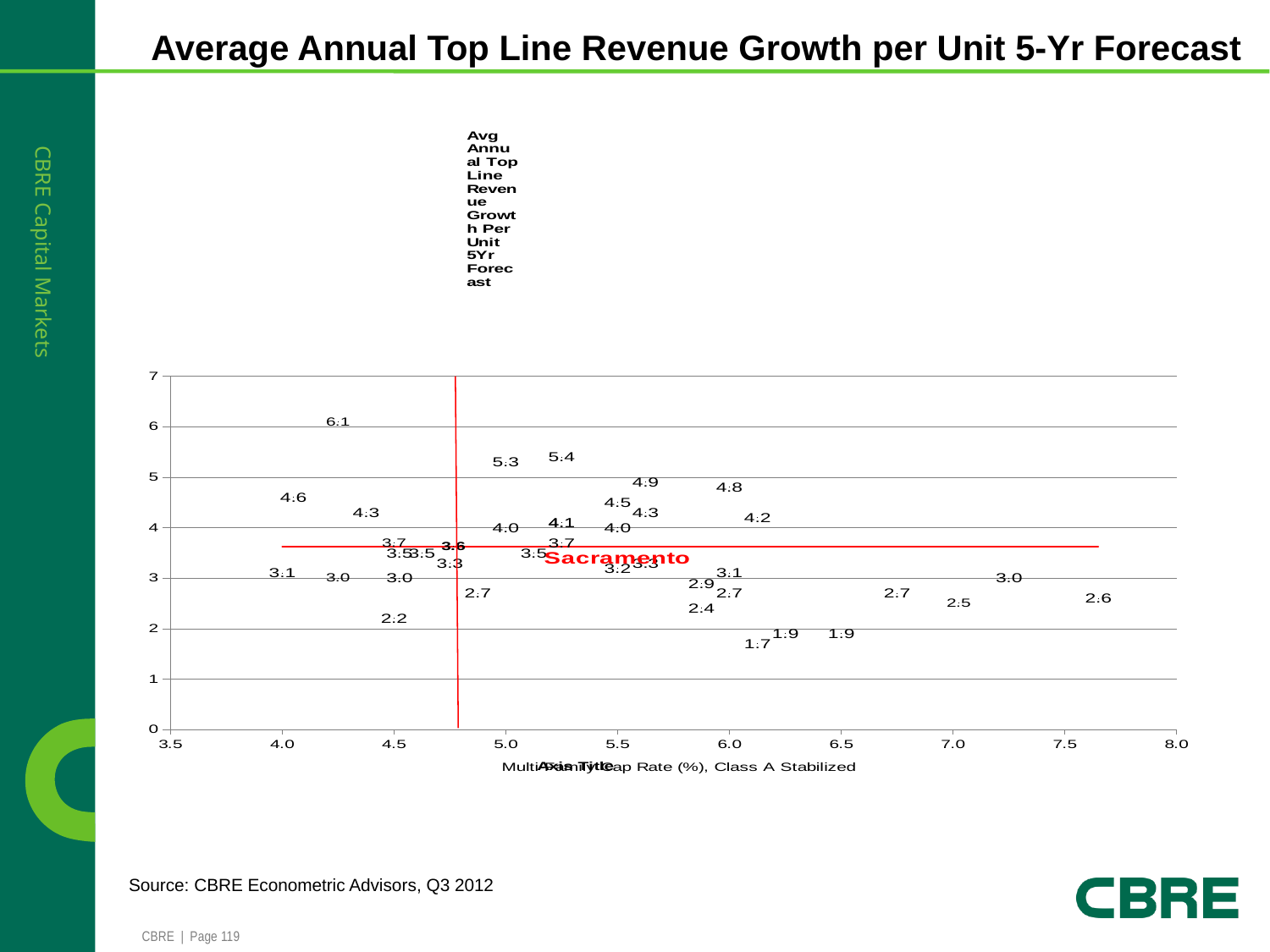
Is the cap rate (x-axis value) for Sacramento greater or less than 4.5? greater What is the highest data label value shown on the chart? 6.1 What is the average annual top line revenue growth per unit 5-yr forecast value labeled for Sacramento? 3.6 What is the label of the x-axis? Multifamily Cap Rate (%), Class A Stabilized What is the difference between the highest data label (6.1) and the lowest data label (1.7) on the chart? 4.4 What is the title of the chart on the slide? Average Annual Top Line Revenue Growth per Unit 5-Yr Forecast Is the cap rate (x-axis value) for Sacramento greater or less than 5.0? less Which is larger, the data point labeled 6.1 or the data point labeled 5.4? 6.1 What is the lowest data label value shown on the chart? 1.7 What kind of chart is shown on the slide? scatter chart Is the value for Sacramento greater or less than 3? greater